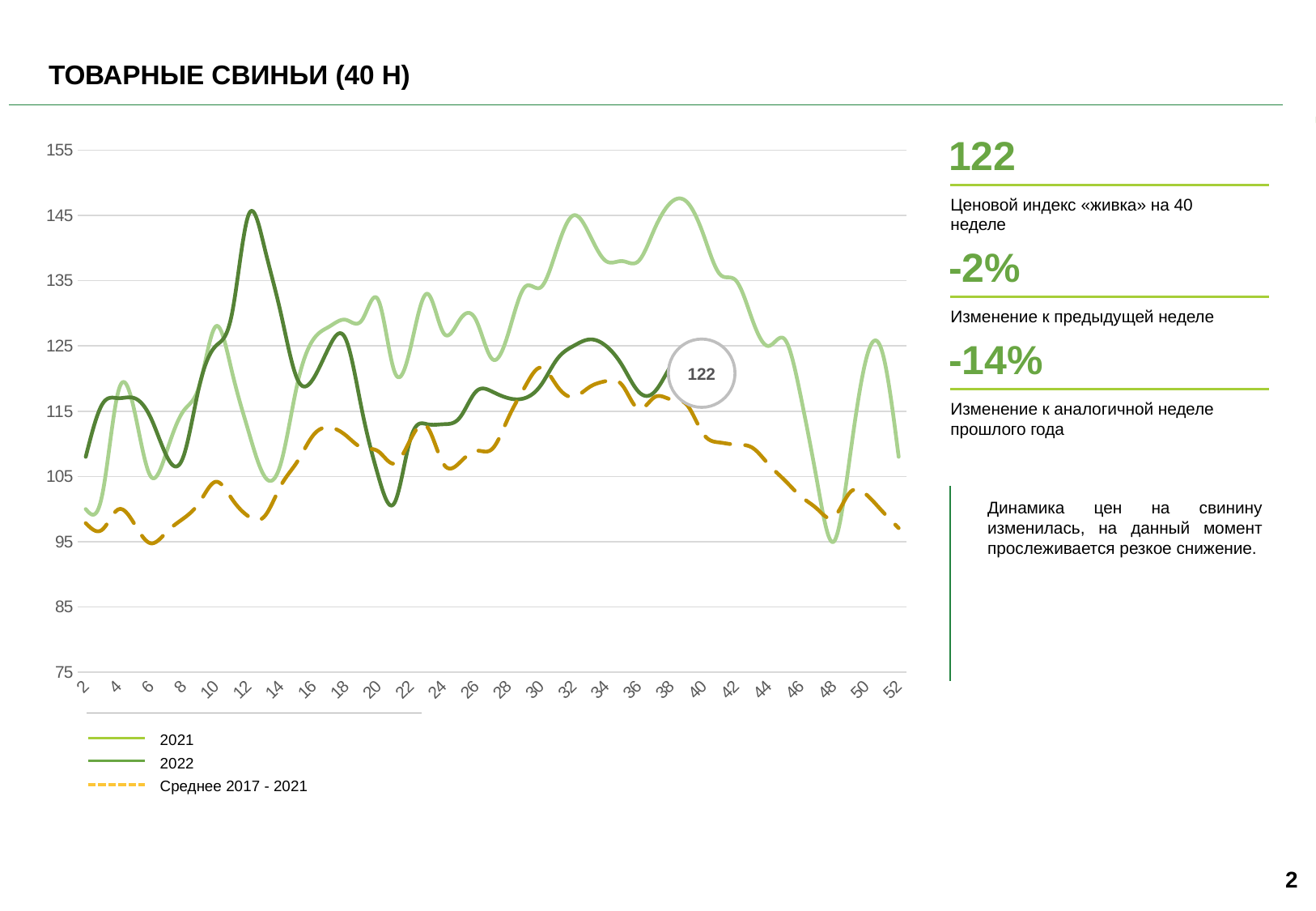
Is the value of the 2021 line at week 48 greater or less than 105? less Is the value of the Среднее 2017 - 2021 line at week 6 greater or less than 105? less At week 40, which line is higher, 2021 or 2022? 2021 What kind of chart is shown on the slide? line chart How many week labels are shown on the x axis? 26 Which series is drawn with a dashed line? Среднее 2017 - 2021 At week 12, which line is higher, 2021 or 2022? 2022 Is the value of the 2022 line at week 12 greater or less than 135? greater Does the 2021 line rise or fall between week 40 and week 48? fall How many series does the legend list? 3 What value is labelled on the 2022 line at week 40? 122